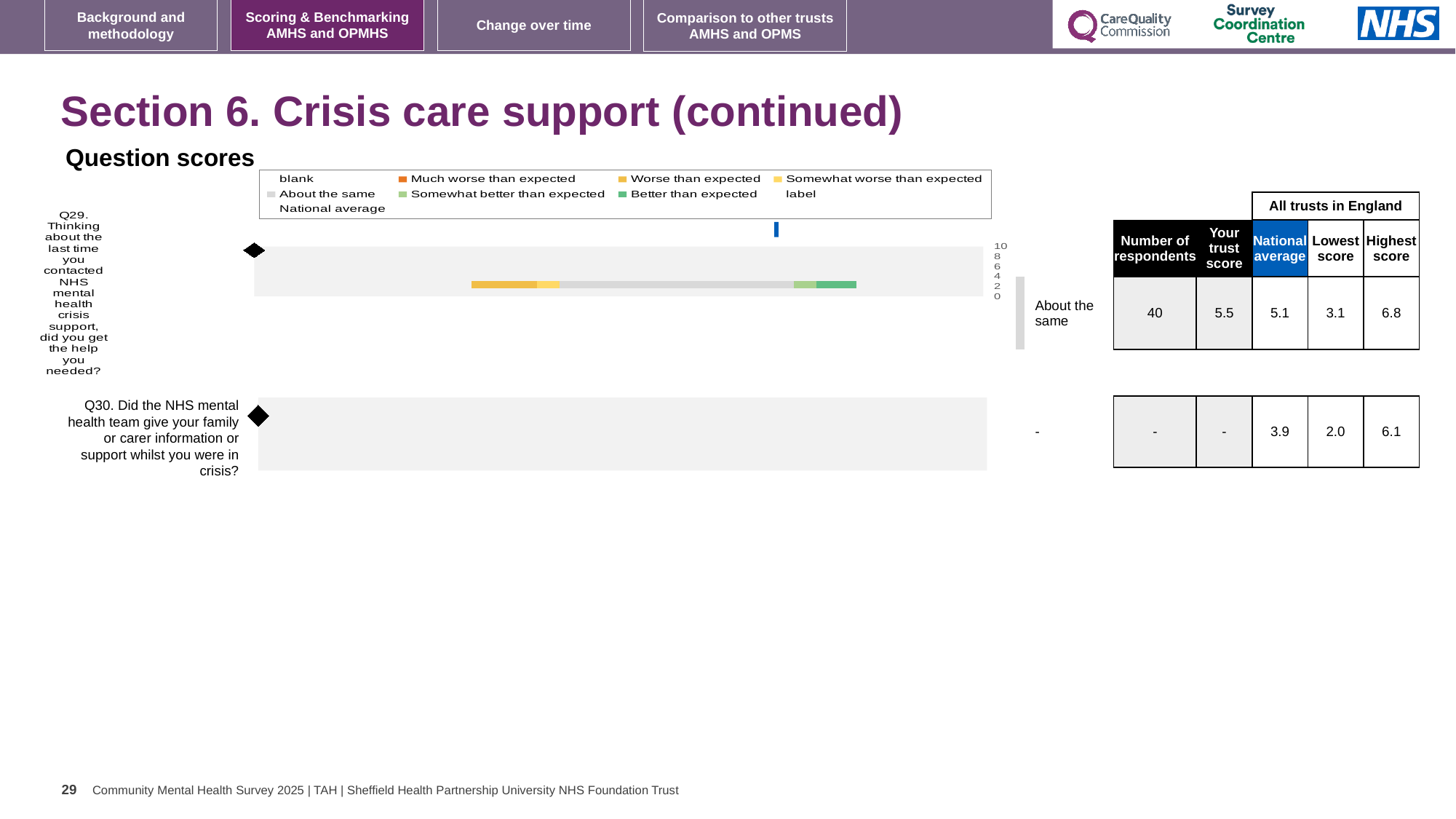
What is the national average score for Q29? 5.1 For Q29, which is larger: the trust score or the national average? the trust score What kind of chart is used to show the question scores on this slide? bar chart What is the highest score across all trusts in England for Q29? 6.8 Which benchmark category is shown for Q29 next to the chart? About the same What is the trust score for Q29 (getting the help needed from NHS mental health crisis support)? 5.5 What is the lowest score across all trusts in England for Q29? 3.1 What is the national average score for Q30 (information or support for family or carer whilst in crisis)? 3.9 For Q29, what is the difference between the highest and lowest scores across all trusts in England? 3.7 What is the number of respondents for Q29 in the question scores table? 40 What colour does the chart legend use for 'Better than expected'? green How many questions are plotted in the question scores chart? 2